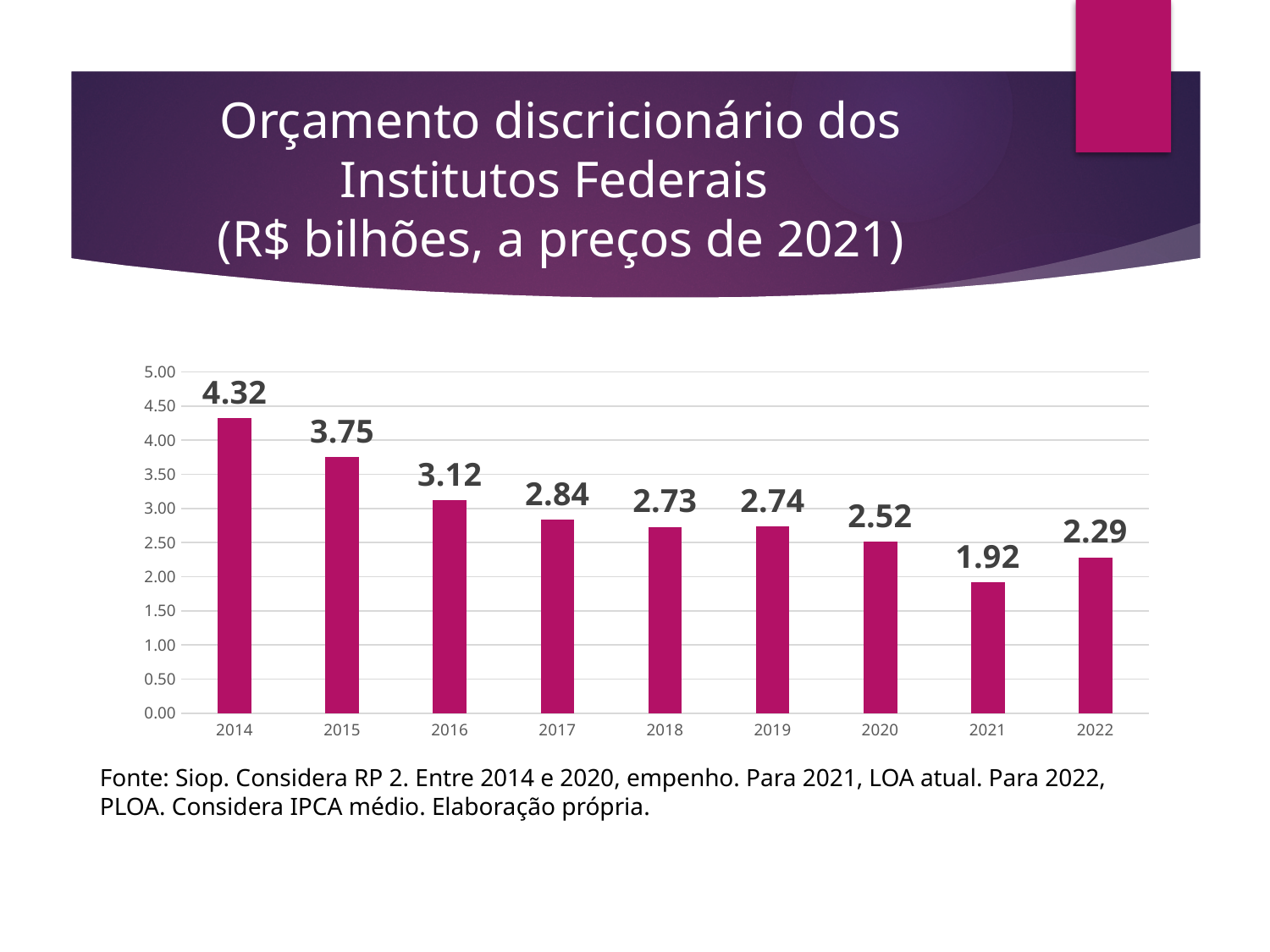
What is the value for 2022? 2.29 Do the values generally rise or fall from 2014 to 2021? fall What is the value for 2021? 1.92 What is the value for 2014? 4.32 How many years are shown on the x axis? 9 Is the value for 2017 greater or less than 2.50? greater What is the difference between the values for 2014 and 2022? 2.03 Which year has the lowest value? 2021 What kind of chart is shown on the slide? bar chart What is the difference between the values for 2015 and 2016? 0.63 Which year has the highest value? 2014 Which is larger, the value for 2020 or the value for 2022? 2020